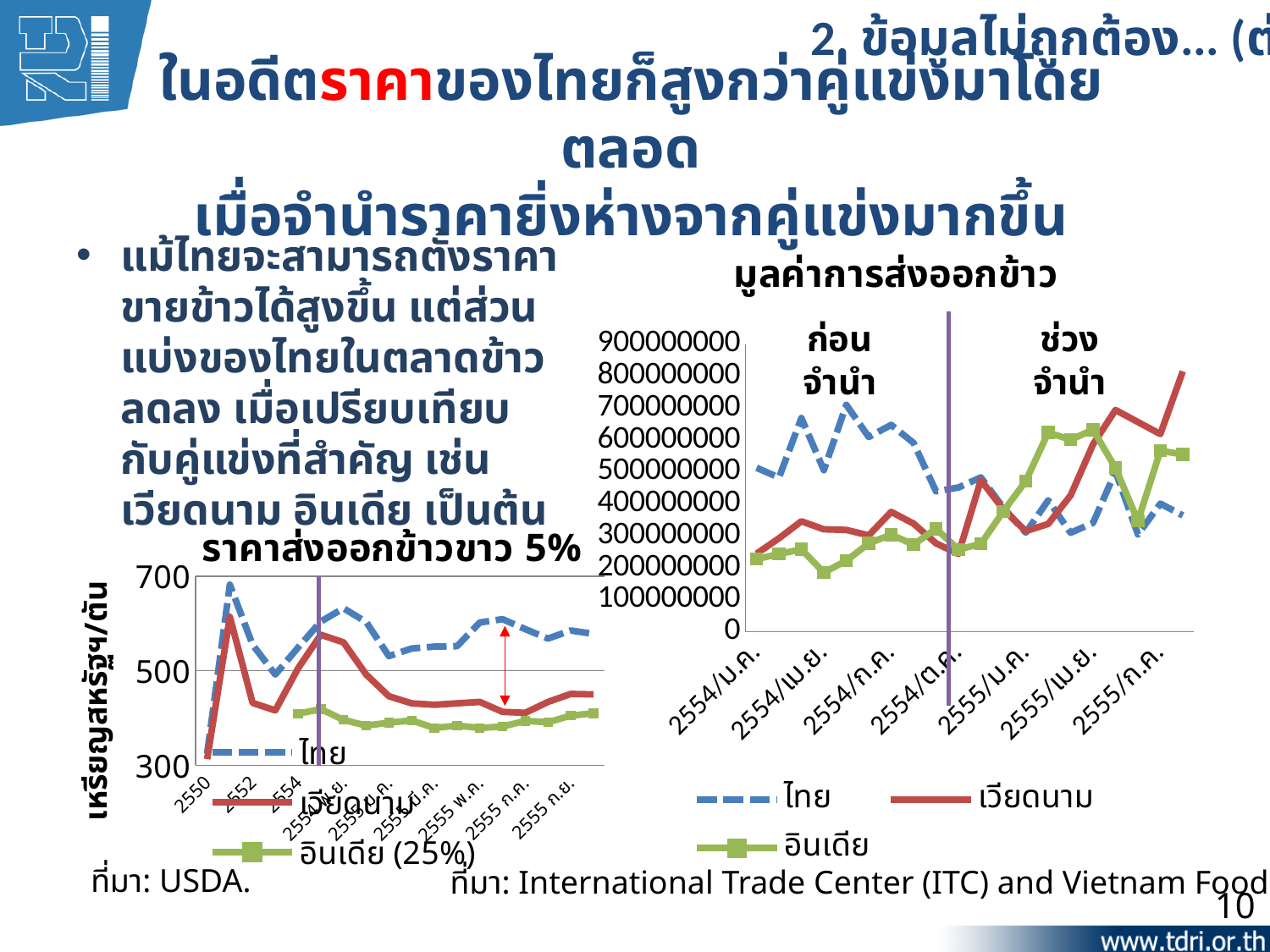
How many series does the legend of the chart titled "มูลค่าการส่งออกข้าว" list? 3 In the chart titled "ราคาส่งออกข้าวขาว 5%", is the value for อินเดีย (25%) at 2555 ก.ย. greater or less than 500? less What kind of chart is the chart titled "มูลค่าการส่งออกข้าว" on the right of the slide? line chart In the chart titled "มูลค่าการส่งออกข้าว", which series has the highest value at 2555/ก.ค.? เวียดนาม In the chart titled "มูลค่าการส่งออกข้าว", is the value for อินเดีย at 2554/ม.ค. greater or less than 300000000? less What is the y-axis label of the chart titled "ราคาส่งออกข้าวขาว 5%"? เหรียญสหรัฐฯ/ตัน In the chart titled "ราคาส่งออกข้าวขาว 5%", is the value for ไทย at 2555 ก.ย. greater or less than 500? greater In the chart titled "มูลค่าการส่งออกข้าว", which series has the highest value at 2554/ม.ค.? ไทย How many series does the legend of the chart titled "ราคาส่งออกข้าวขาว 5%" list? 3 What kind of chart is the chart titled "ราคาส่งออกข้าวขาว 5%" on the left of the slide? line chart In the chart titled "มูลค่าการส่งออกข้าว", does the value for เวียดนาม rise or fall overall from 2554/ม.ค. to 2555/ก.ค.? rise